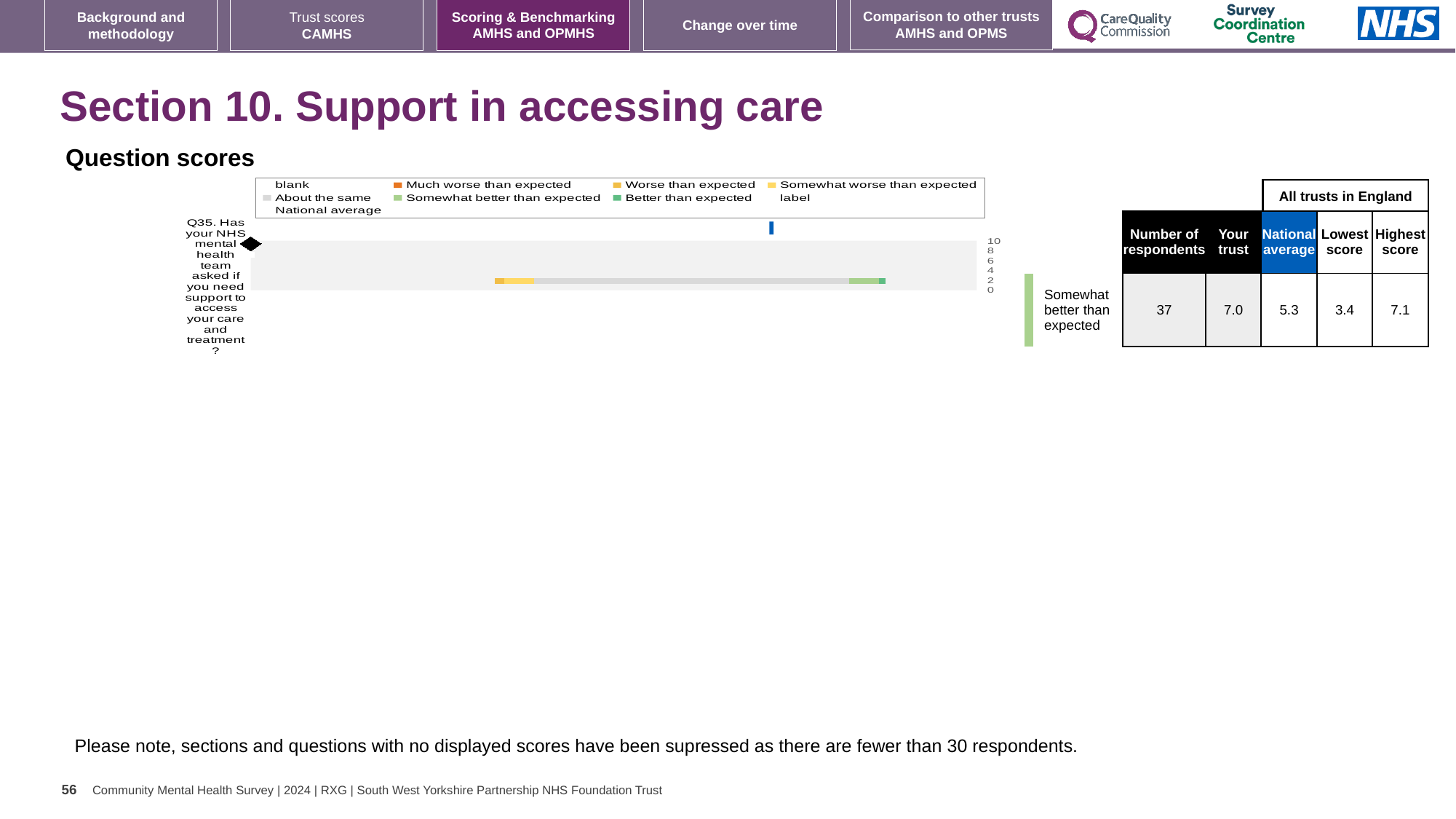
What is the highest value shown on the chart's axis? 10 What kind of chart is shown on the slide? bar chart What is the highest score among all trusts in England for Q35? 7.1 What rating is given for Q35 next to the chart? Somewhat better than expected What is the 'Your trust' score for Q35? 7.0 Which question is plotted in the chart? Q35. Has your NHS mental health team asked if you need support to access your care and treatment? How many entries does the chart legend list? 9 What is the number of respondents for Q35? 37 What is the national average score for Q35? 5.3 Which is larger for Q35, the 'Your trust' score or the national average? Your trust How many questions (categories) are plotted in the chart? 1 What is the lowest score among all trusts in England for Q35? 3.4